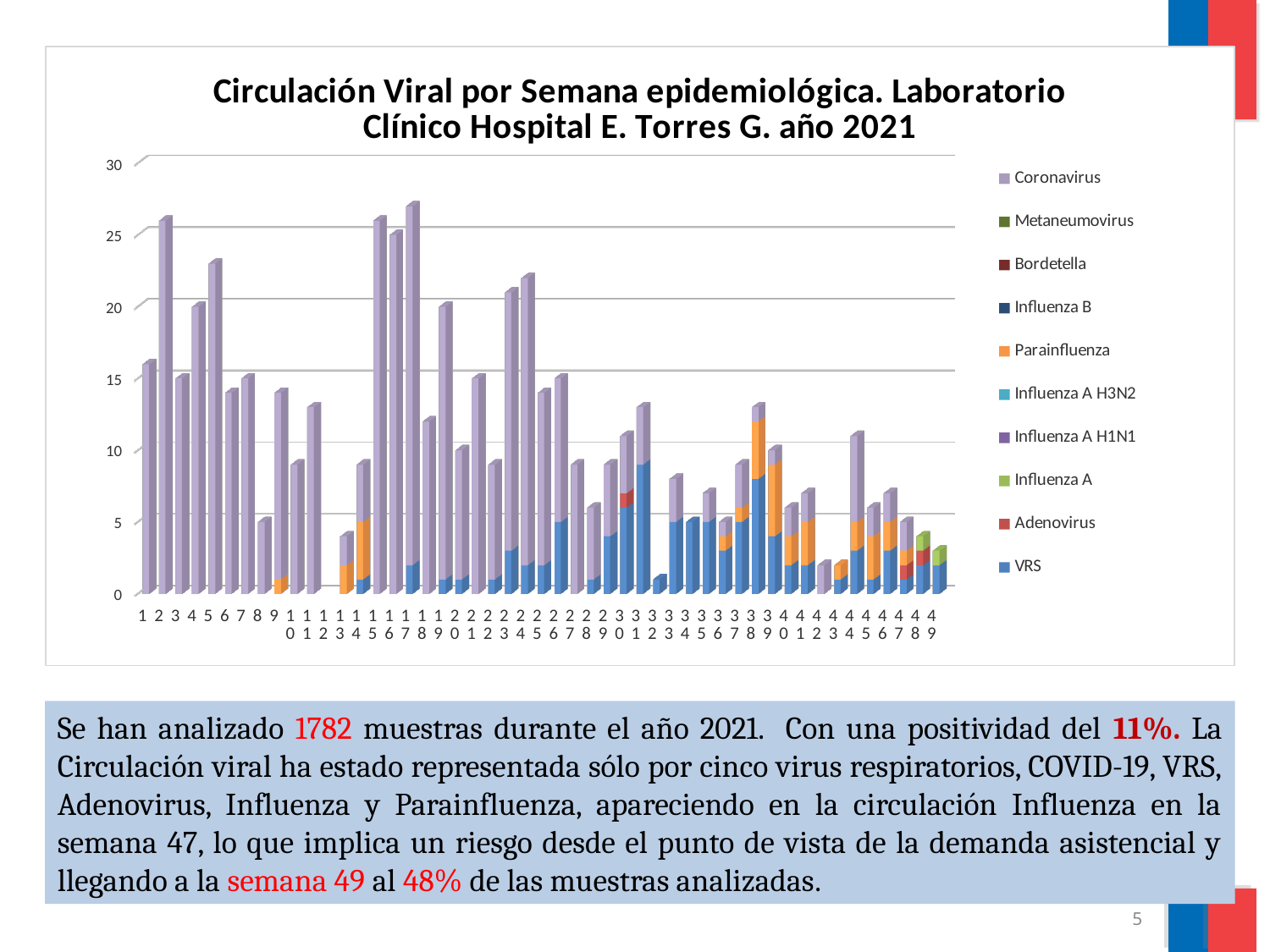
Is the total value for week 32 greater or less than 5? less Is the total value for week 38 greater or less than 10? greater How many series does the legend list? 10 Is the total value for week 42 greater or less than 5? less From week 17 to week 32, do the total values generally rise or fall? Fall Which series is listed first in the legend? Coronavirus How many epidemiological weeks are shown on the x axis? 49 What is the title of the chart? Circulación Viral por Semana epidemiológica. Laboratorio Clínico Hospital E. Torres G. año 2021 What kind of chart is shown on the slide? Stacked bar chart Which week has the larger total, week 2 or week 32? Week 2